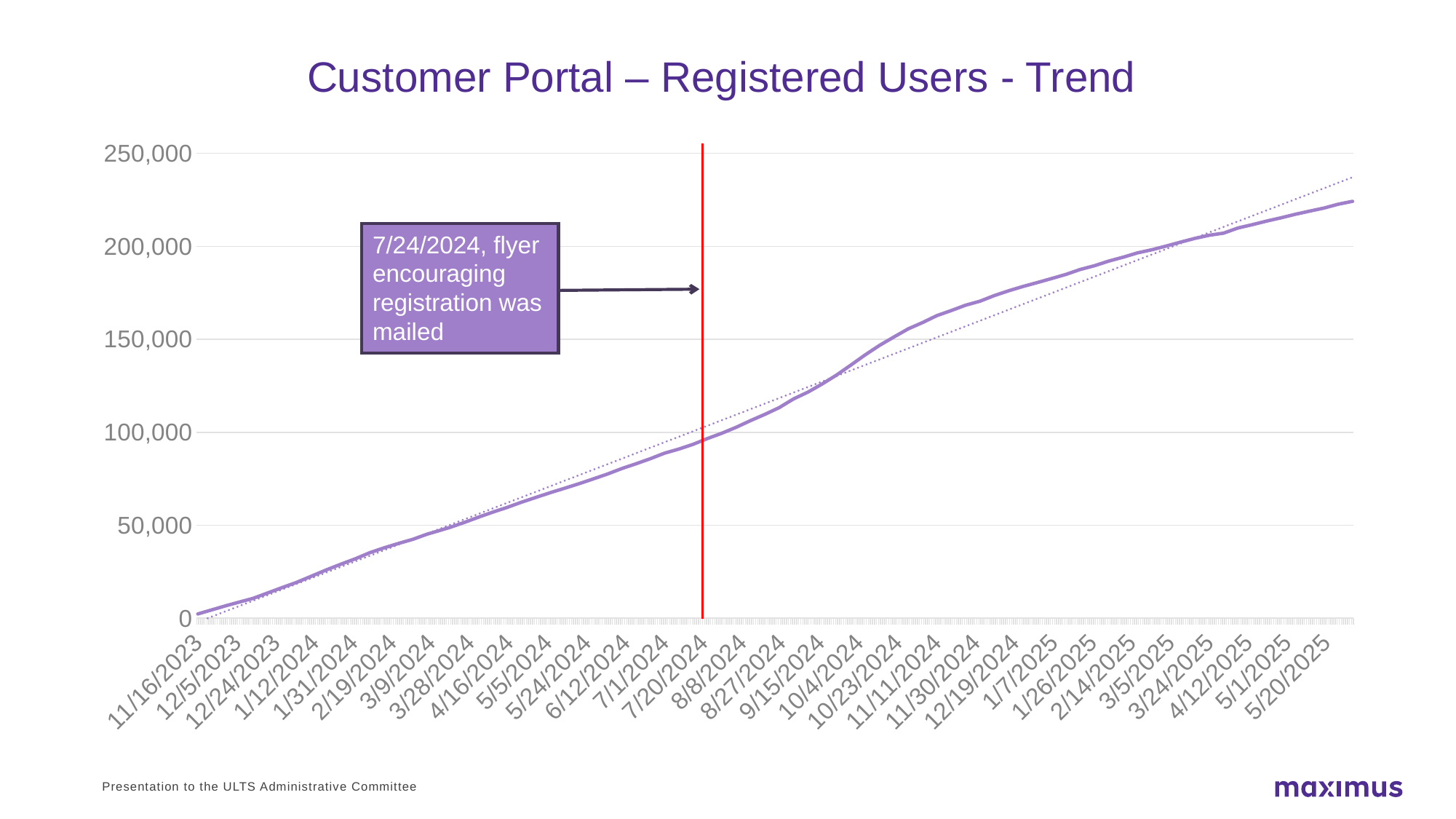
Which date on the x axis has the lowest number of registered users? 11/16/2023 Is the value for 3/9/2024 greater or less than 50,000? less What is the title of the chart? Customer Portal – Registered Users - Trend What event does the annotation box on the chart describe? 7/24/2024, flyer encouraging registration was mailed What kind of chart is shown on the slide? Line chart Do the registered user values rise or fall from 11/16/2023 to 5/20/2025? Rise Is the value for 1/7/2025 greater or less than 200,000? less Is the value for 9/15/2024 greater or less than 100,000? greater Which date on the x axis has the highest number of registered users? 5/20/2025